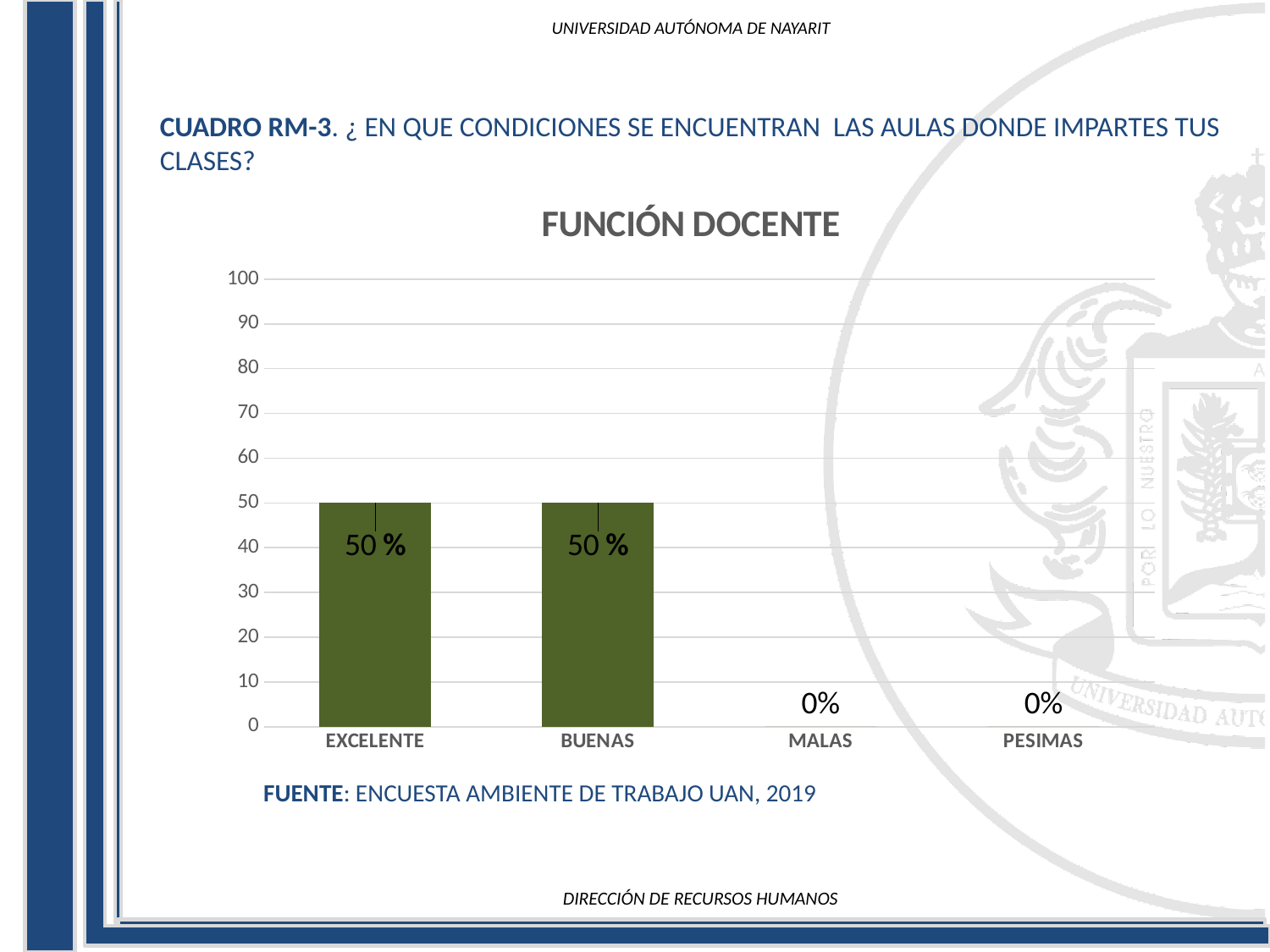
What kind of chart is shown on the slide? bar chart What is the value for MALAS? 0% Is the value for EXCELENTE greater or less than 70? less What is the title of the chart? FUNCIÓN DOCENTE What is the value for PESIMAS? 0% How many categories are shown on the x axis? 4 What is the difference between the values for EXCELENTE and MALAS? 50 % What is the value for BUENAS? 50 % What is the value for EXCELENTE? 50 % What is the highest value shown on the y axis? 100 Which is larger, the value for BUENAS or the value for PESIMAS? BUENAS Which category has the lowest value, EXCELENTE or MALAS? MALAS